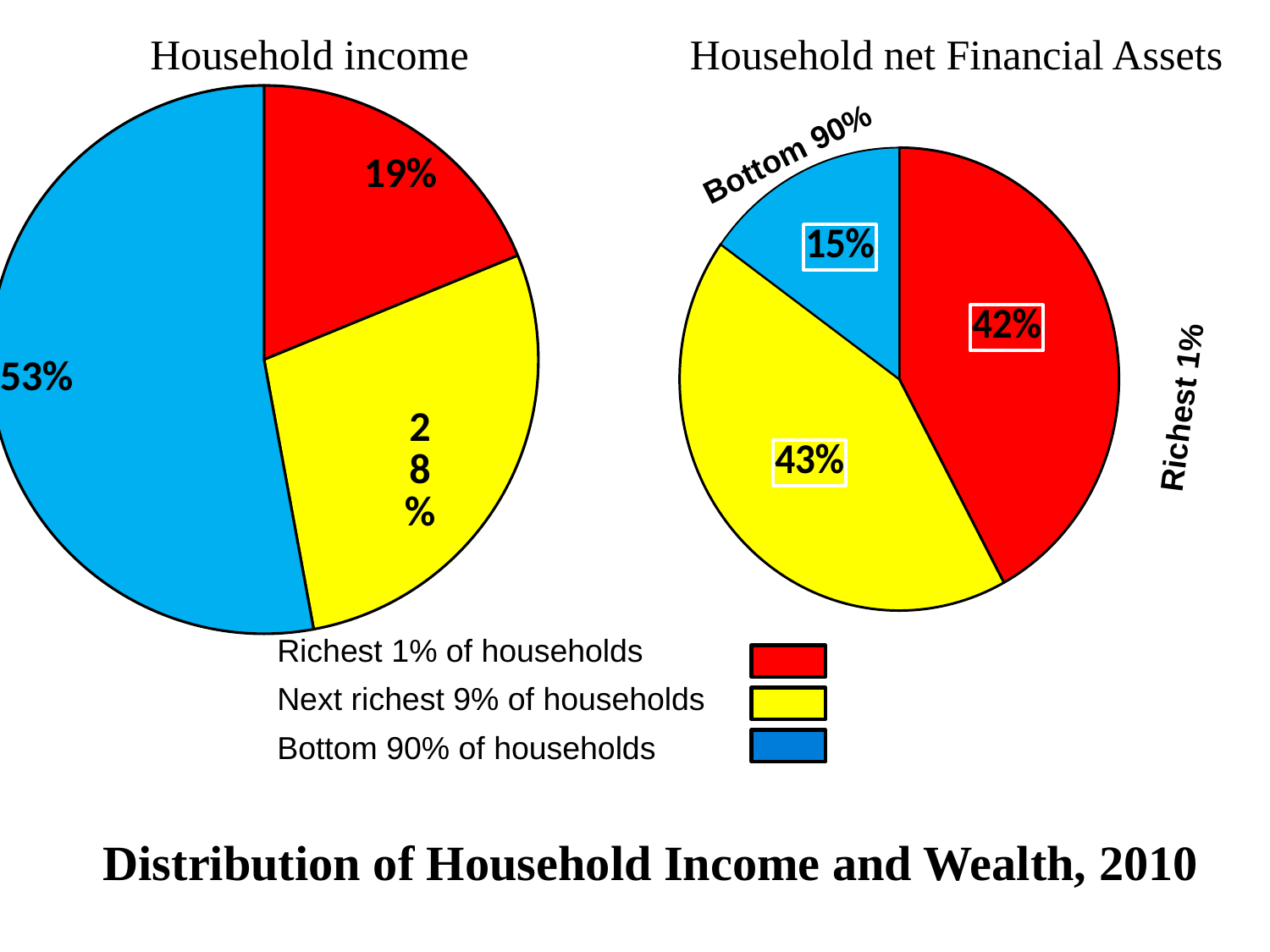
In the Household income chart, what share of income goes to the bottom 90% of households? 53% Which colour represents the richest 1% of households in the legend? Red In the Household income chart, what share of income goes to the richest 1% of households? 19% What is the difference between the bottom 90% share in the Household income chart and the bottom 90% share in the Household net Financial Assets chart? 38 percentage points In the Household net Financial Assets chart, which group has the smallest share? Bottom 90% of households In the Household net Financial Assets chart, what share is held by the richest 1% of households? 42% What type of chart is the Household income chart? Pie chart In the Household income chart, which group has the largest share? Bottom 90% of households How many groups does the legend list? 3 In the Household income chart, what share of income goes to the next richest 9% of households? 28% In the Household income chart, which is larger: the share of the richest 1% or the share of the next richest 9%? Next richest 9% of households In the Household net Financial Assets chart, what share is held by the bottom 90% of households? 15%